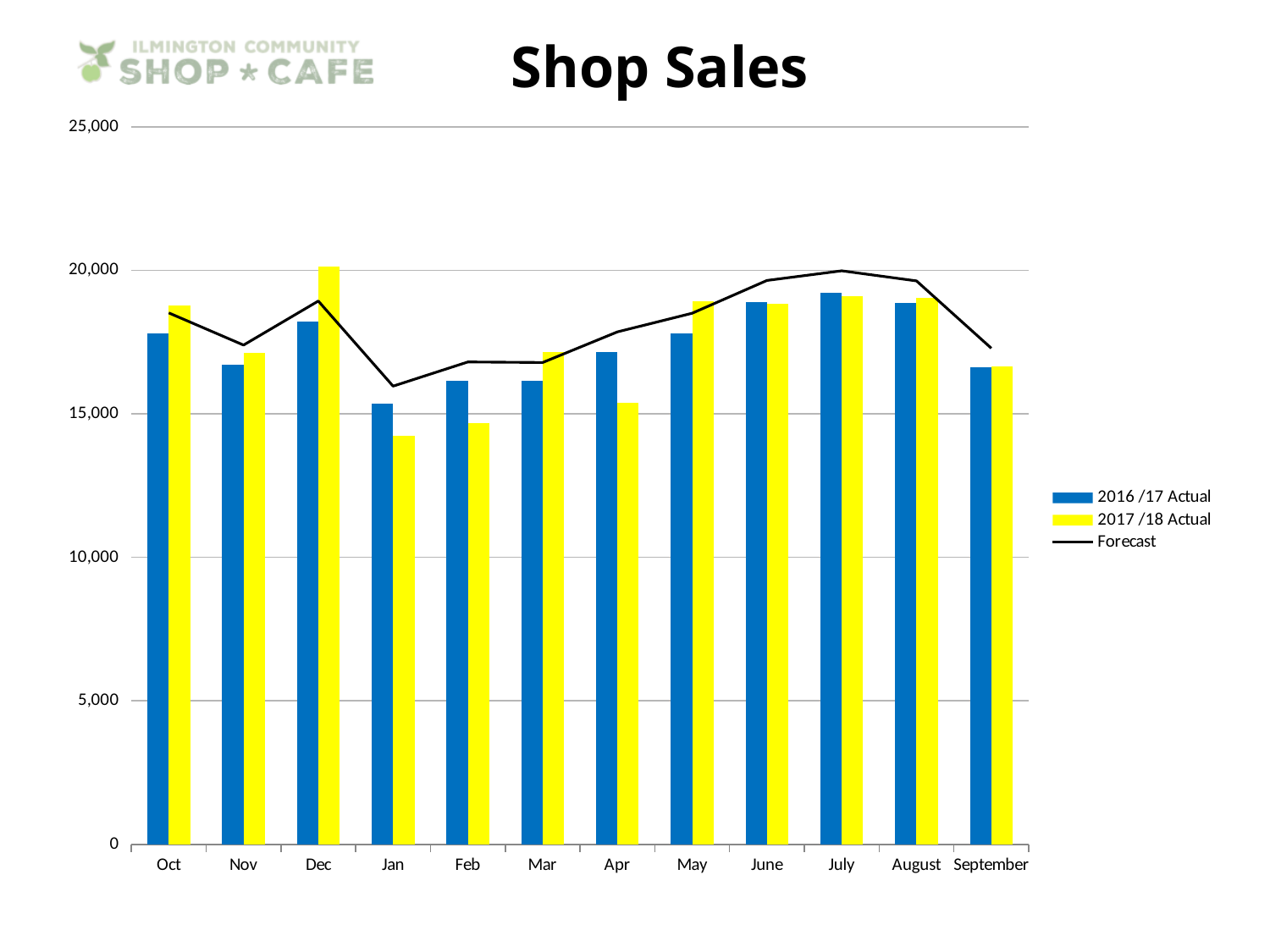
In Dec, which is larger: the 2016 /17 Actual or the 2017 /18 Actual value? 2017 /18 Actual Which month has the highest 2017 /18 Actual value? Dec Which month has the lowest 2016 /17 Actual value? Jan Does the Forecast line rise or fall from Jan to July? rise In Jan, which is larger: the 2016 /17 Actual or the 2017 /18 Actual value? 2016 /17 Actual What kind of chart is used to show the 2016 /17 Actual and 2017 /18 Actual series? bar chart Is the 2017 /18 Actual value for Jan greater or less than 15,000? less How many months are shown on the x axis? 12 Which month has the lowest 2017 /18 Actual value? Jan How many series does the legend list? 3 Is the 2016 /17 Actual value for Apr greater or less than 15,000? greater What is the title of the chart? Shop Sales